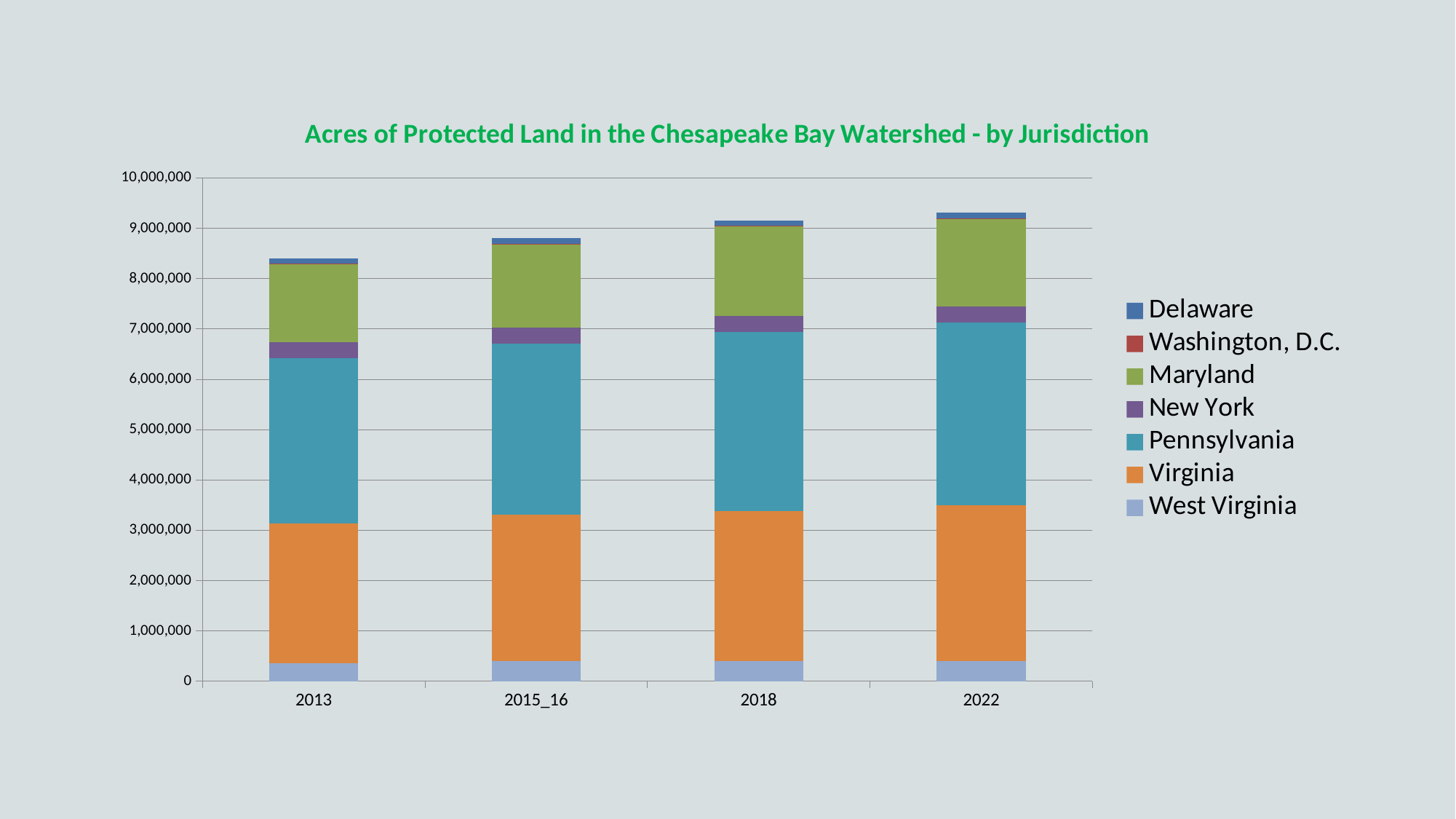
Is the total acreage for 2015_16 greater or less than 8,000,000? greater In 2022, which is larger: the Maryland segment or the New York segment? Maryland Does the total acreage of protected land rise or fall from 2013 to 2022? Rises Is the total acreage for 2013 greater or less than 9,000,000? less Is the total acreage for 2022 greater or less than 9,000,000? greater In 2022, which jurisdiction contributes the largest segment of the bar? Pennsylvania What is the title of the chart? Acres of Protected Land in the Chesapeake Bay Watershed - by Jurisdiction Which year has the highest total acres of protected land? 2022 How many time periods are shown along the x axis? 4 How many jurisdictions does the legend list? 7 Which year has the lowest total acres of protected land? 2013 What kind of chart is shown on the slide? Stacked bar chart